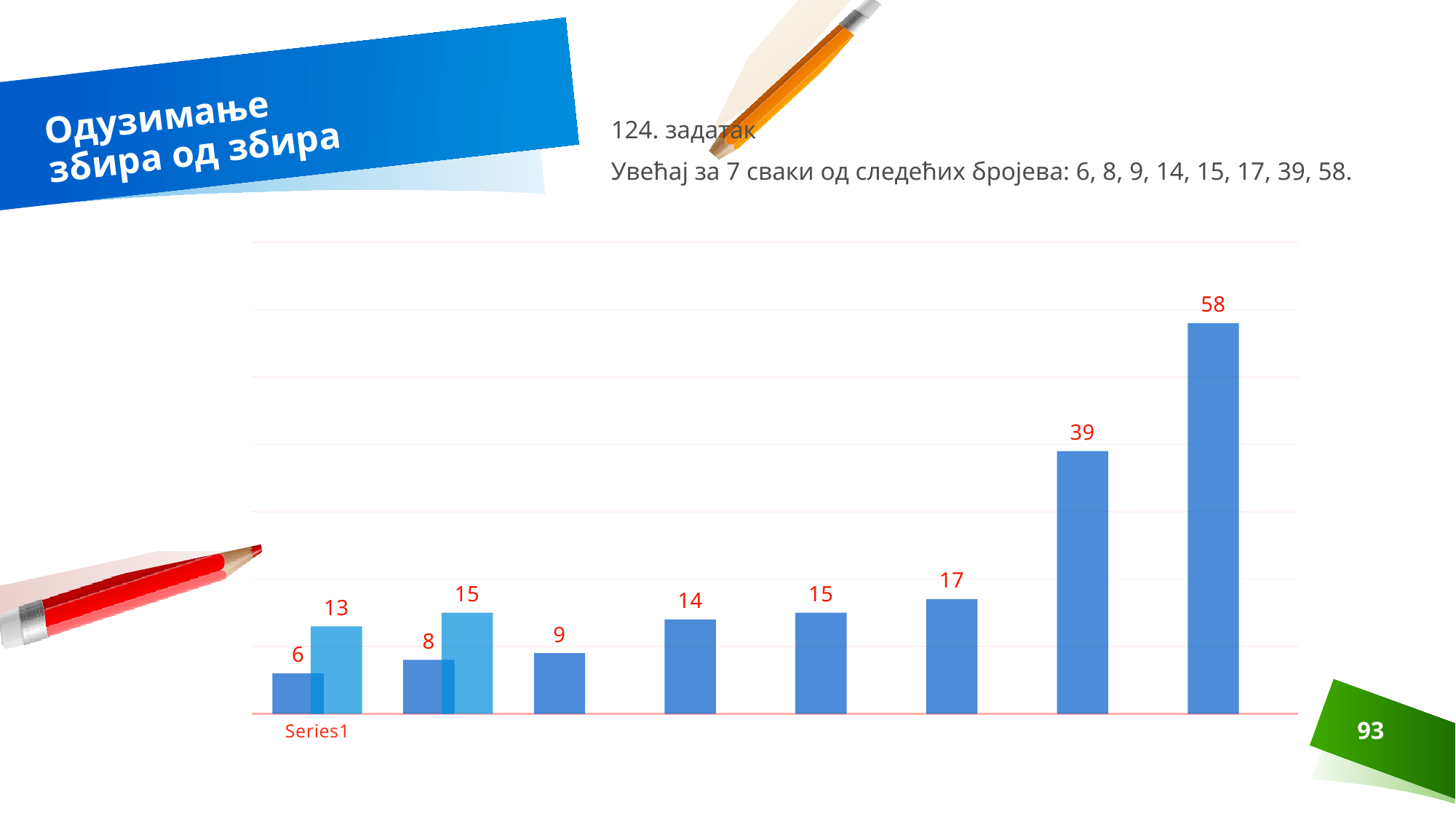
Which is larger, the bar labelled 39 or the bar labelled 17? 39 What is the difference between the two tallest bars, labelled 58 and 39? 19 What kind of chart is shown on the slide? bar chart How many dark blue bars are plotted in the chart? 8 What is the value of the tallest bar in the chart? 58 What is the value of the light blue bar that overlaps the dark blue bar labelled 8? 15 What is the value of the shortest dark blue bar in the chart? 6 What is the value of the first dark blue bar on the left of the chart? 6 What category label is printed under the first bar of the chart? Series1 Do the values of the dark blue bars rise or fall from left to right? rise What is the difference between the light blue bar labelled 13 and the dark blue bar labelled 6 next to it? 7